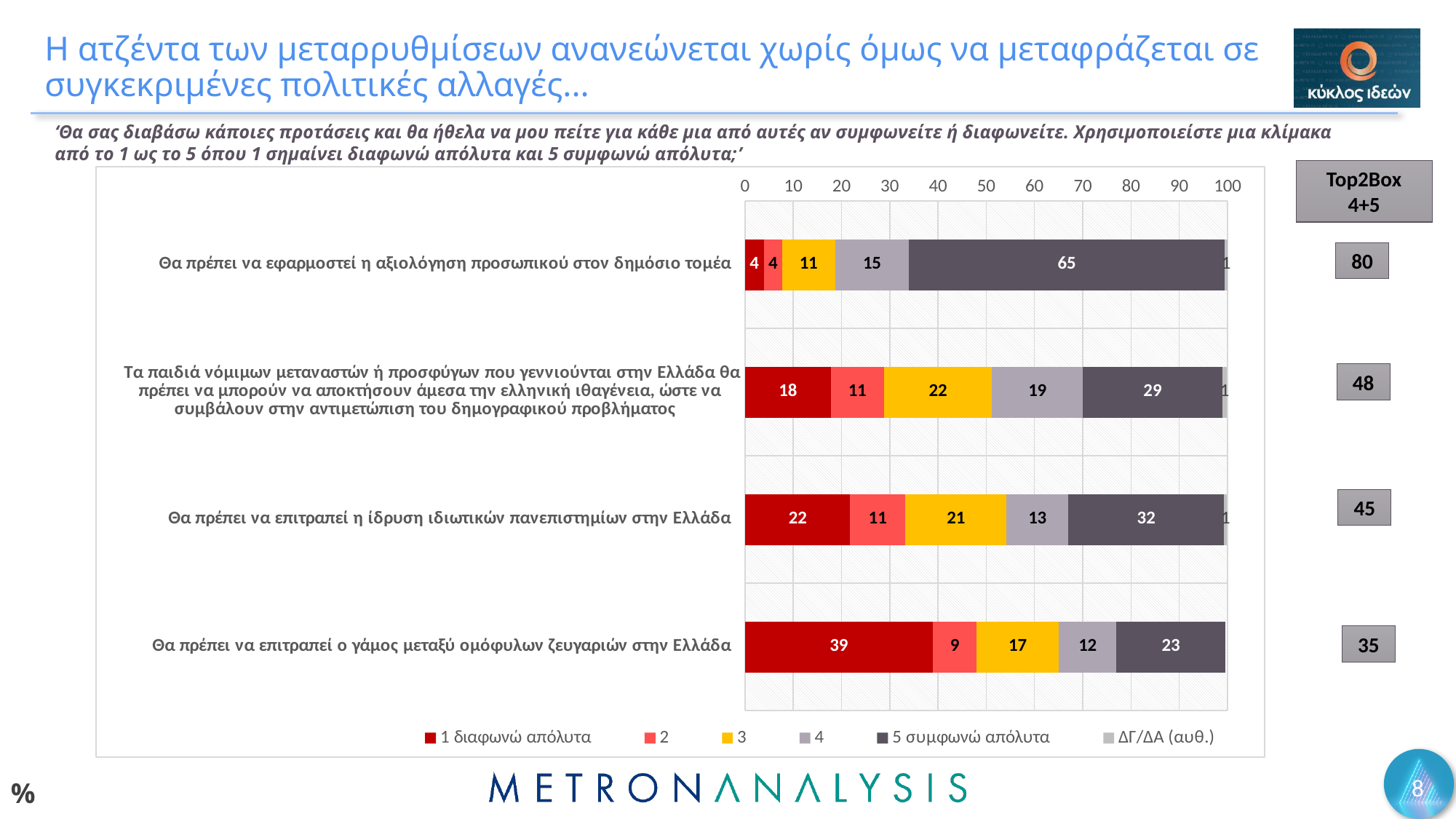
How many series does the chart legend list? 6 What is the total of the '4' and '5 συμφωνώ απόλυτα' segments for 'Θα πρέπει να επιτραπεί ο γάμος μεταξύ ομόφυλων ζευγαριών στην Ελλάδα'? 35 How many statements (categories) are plotted in the chart? 4 What is the value of series '3' for 'Θα πρέπει να επιτραπεί η ίδρυση ιδιωτικών πανεπιστημίων στην Ελλάδα'? 21 Which statement has the lowest value for '1 διαφωνώ απόλυτα'? Θα πρέπει να εφαρμοστεί η αξιολόγηση προσωπικού στον δημόσιο τομέα Which statement has the highest value for '5 συμφωνώ απόλυτα'? Θα πρέπει να εφαρμοστεί η αξιολόγηση προσωπικού στον δημόσιο τομέα What kind of chart is shown on the slide? Stacked bar chart What is the Top2Box (4+5) value shown for 'Τα παιδιά νόμιμων μεταναστών ή προσφύγων που γεννιούνται στην Ελλάδα...'? 48 What is the difference between the '5 συμφωνώ απόλυτα' value for the public sector evaluation statement (65) and for the same-sex marriage statement (23)? 42 What is the value of '5 συμφωνώ απόλυτα' for 'Θα πρέπει να εφαρμοστεί η αξιολόγηση προσωπικού στον δημόσιο τομέα'? 65 What is the value of '1 διαφωνώ απόλυτα' for 'Θα πρέπει να επιτραπεί ο γάμος μεταξύ ομόφυλων ζευγαριών στην Ελλάδα'? 39 Which is larger: the '1 διαφωνώ απόλυτα' value for the private universities statement or for the children of legal immigrants statement? Private universities statement (22)